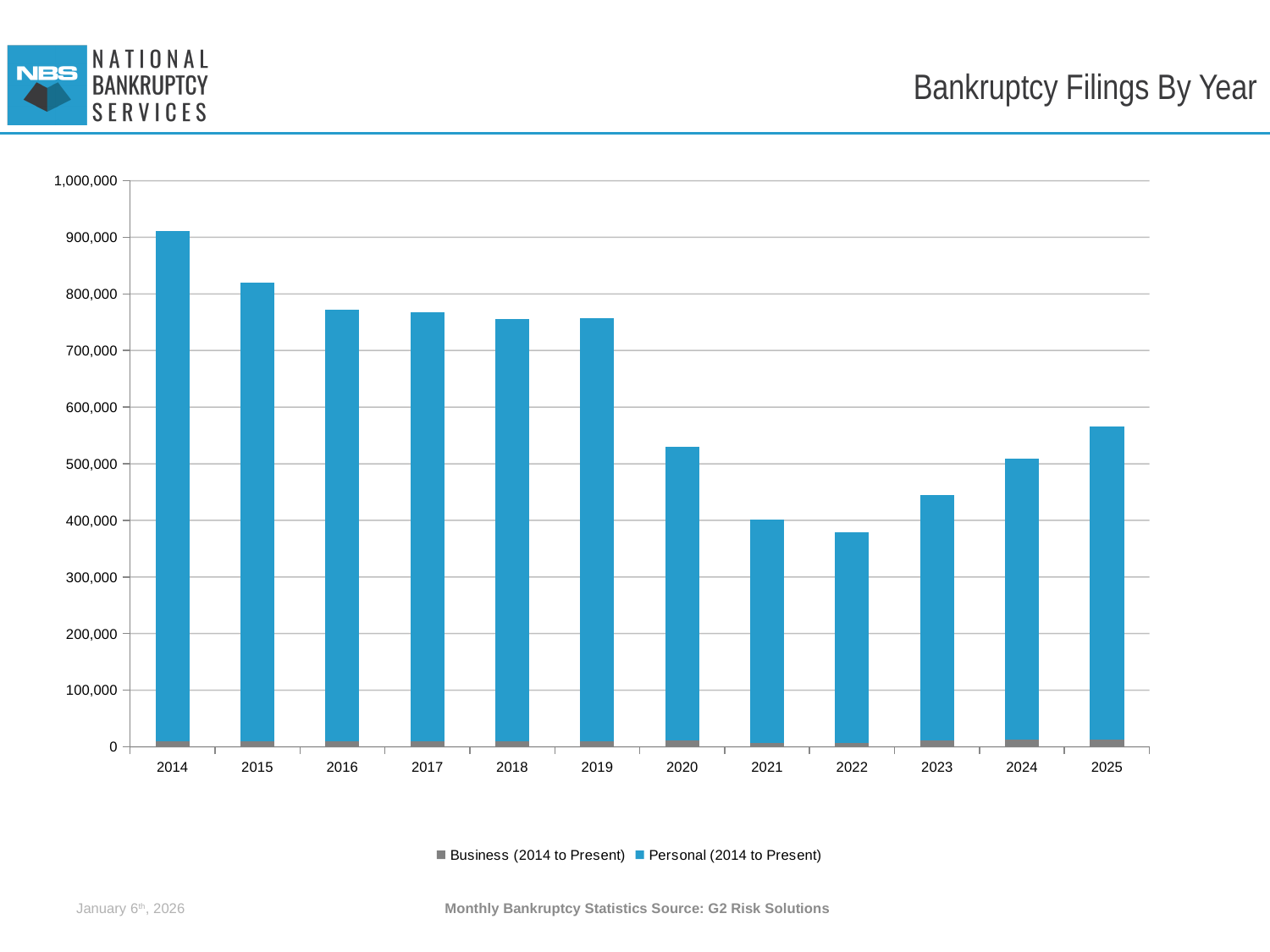
Is the total value for 2025 greater or less than 500,000? greater Which year has the larger total, 2020 or 2021? 2020 Is the total value for 2023 greater or less than 500,000? less Is the total value for 2015 greater or less than 800,000? greater How many series does the legend list? 2 Which year has the lowest total bankruptcy filings? 2022 Which year has the highest total bankruptcy filings? 2014 How many years are shown on the x axis of the chart? 12 Which series is shown in grey in the legend? Business (2014 to Present) What kind of chart is shown on the slide? bar chart Do the total filings rise or fall from 2022 to 2025? rise